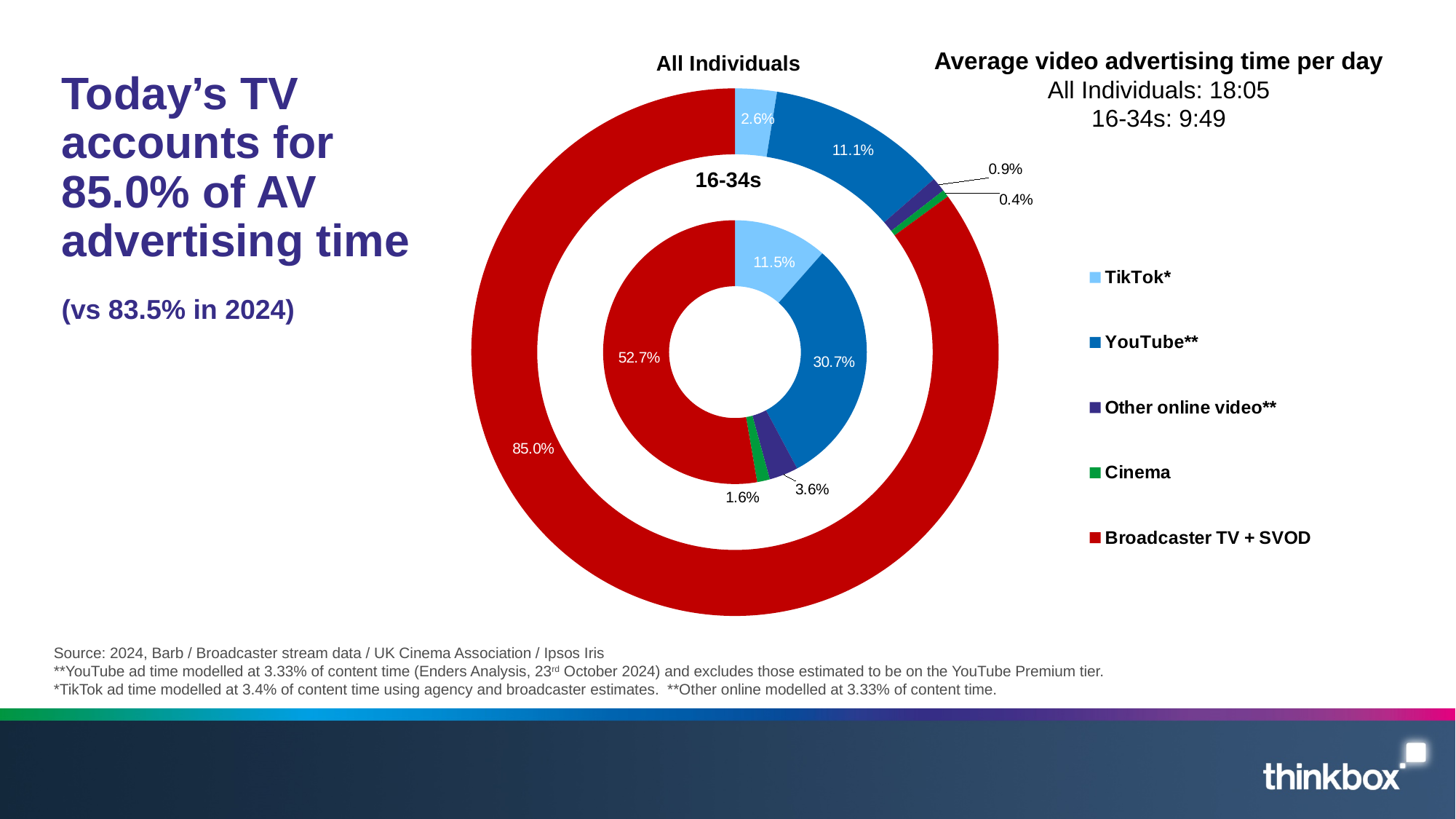
What kind of chart is shown on the slide? Doughnut chart What is the YouTube** share for the 16-34s ring? 30.7% What is the TikTok* share for All Individuals? 2.6% What share of AV advertising time does Broadcaster TV + SVOD account for among All Individuals? 85.0% How many series does the legend list? 5 Which ring of the doughnut chart represents 16-34s, the inner or the outer? Inner Which category has the largest share in the 16-34s ring? Broadcaster TV + SVOD What is the difference between the Broadcaster TV + SVOD share for All Individuals and for 16-34s? 32.3 percentage points What is the Other online video** share for All Individuals? 0.9% Which is larger: the TikTok* share for 16-34s or the YouTube** share for All Individuals? TikTok* share for 16-34s What is the Cinema share in the 16-34s ring? 1.6% Which category has the smallest share in the All Individuals ring? Cinema